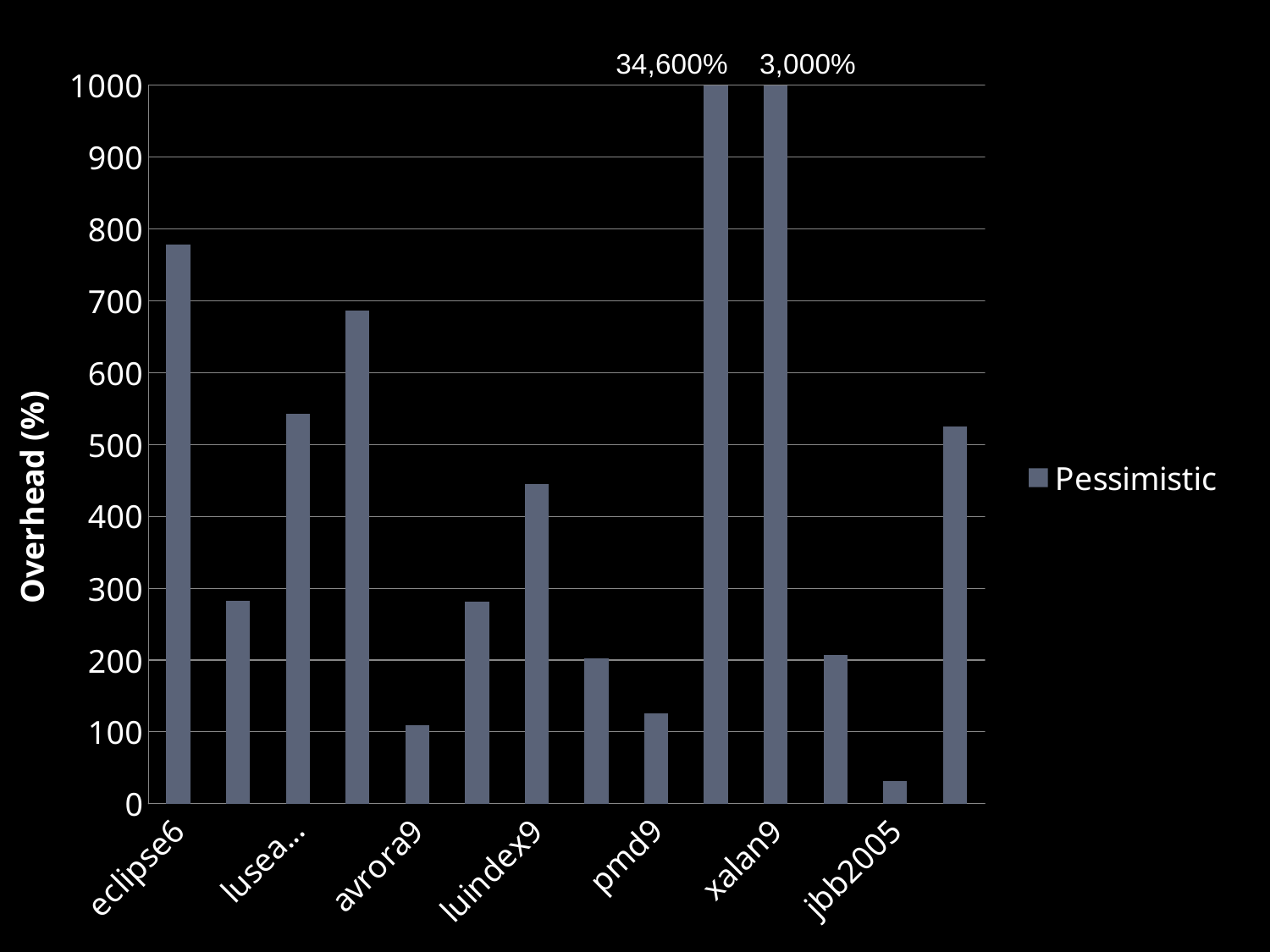
What is the name of the series shown in the legend? Pessimistic What is the title of the vertical axis? Overhead (%) Is the overhead for avrora9 greater or less than 200? less Is the overhead for eclipse6 greater or less than 700? greater Which labeled category has the lowest overhead? jbb2005 How many bars are plotted in the chart? 14 Is the overhead for luindex9 greater or less than 400? greater What kind of chart is shown on the slide? bar chart How many series does the legend list? 1 What is the overhead value printed for xalan9? 3,000% What is the largest data label printed on the chart? 34,600% Which has the higher overhead, eclipse6 or pmd9? eclipse6